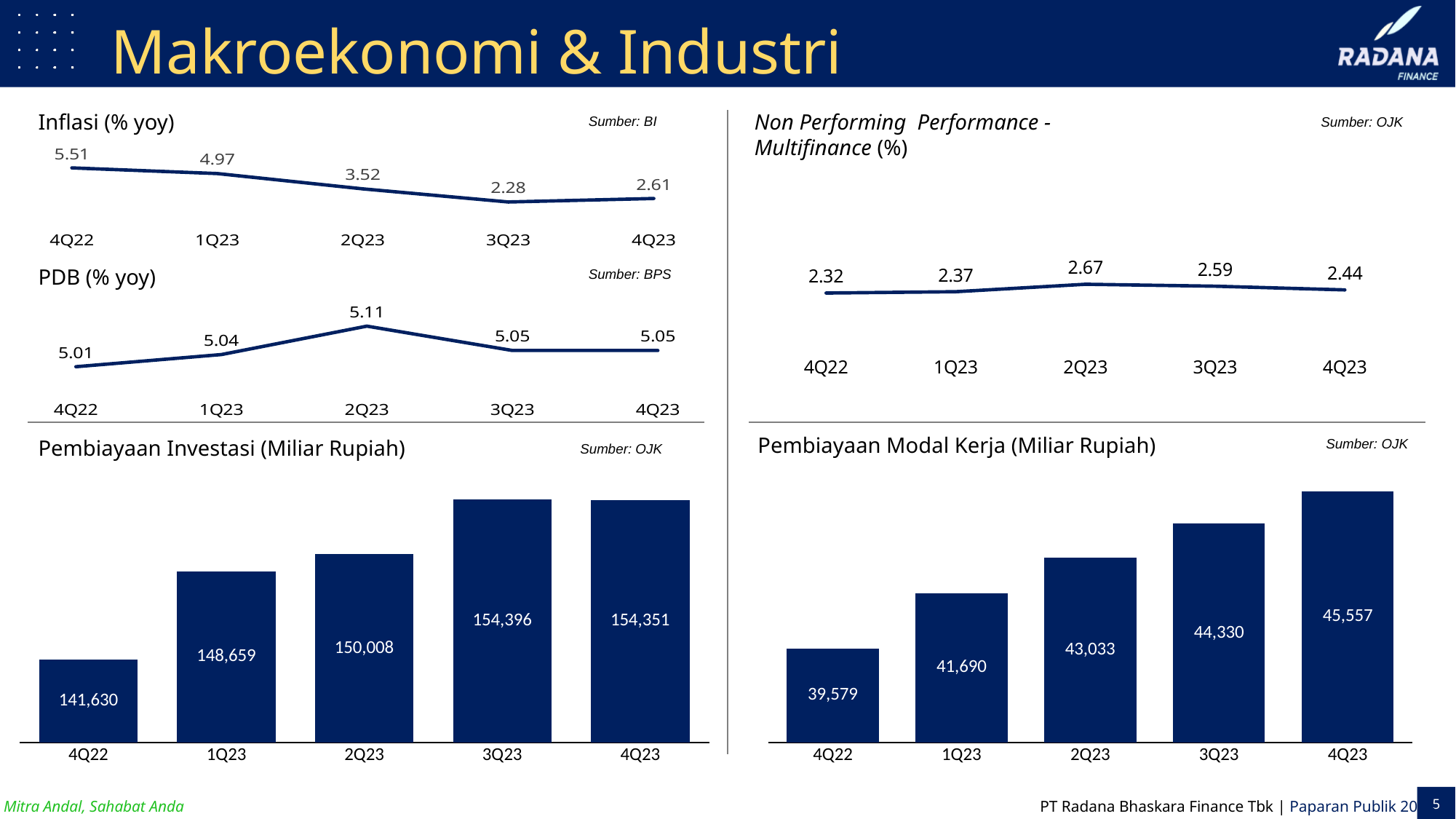
In the Pembiayaan Investasi (Miliar Rupiah) chart, what is the value for 1Q23? 148,659 In the Pembiayaan Investasi (Miliar Rupiah) chart, what is the difference between the 3Q23 and 4Q23 values? 45 In the Inflasi (% yoy) chart, what is the difference between the 4Q22 and 4Q23 values? 2.90 In the Inflasi (% yoy) chart, what is the value for 2Q23? 3.52 In the Non Performing Performance - Multifinance (%) chart, what is the value for 3Q23? 2.59 In the Inflasi (% yoy) chart, which quarter has the lowest value? 3Q23 In the Pembiayaan Modal Kerja (Miliar Rupiah) chart, do the values rise or fall from 4Q22 to 4Q23? Rise In the Non Performing Performance - Multifinance (%) chart, which is larger, the value for 1Q23 or the value for 4Q23? 4Q23 In the Pembiayaan Modal Kerja (Miliar Rupiah) chart, what is the value for 4Q23? 45,557 What kind of chart is the Pembiayaan Investasi (Miliar Rupiah) chart? Bar chart In the PDB (% yoy) chart, what is the value for 4Q22? 5.01 In the PDB (% yoy) chart, which quarter has the highest value? 2Q23